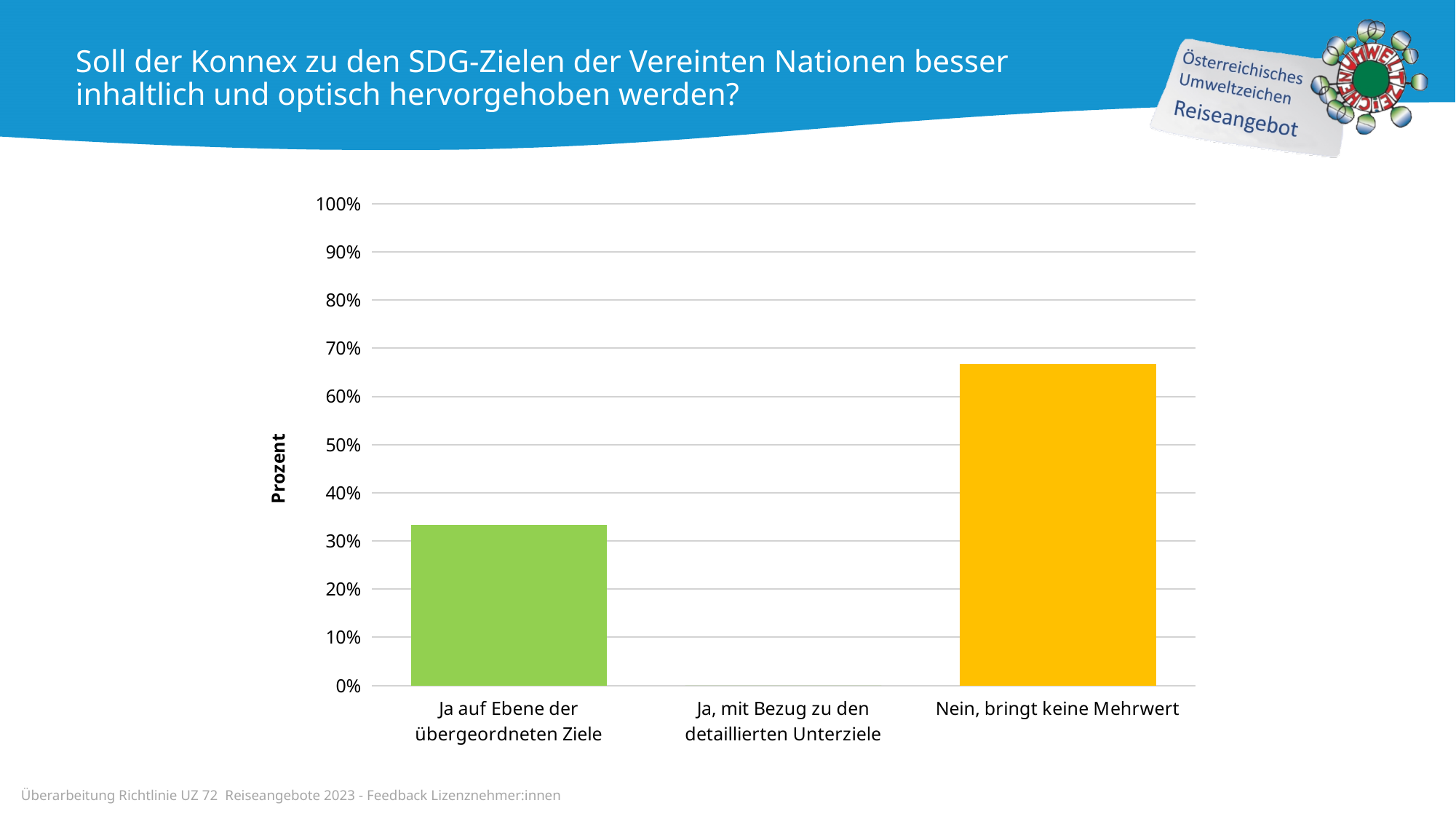
Is the value for "Ja auf Ebene der übergeordneten Ziele" greater or less than 40%? less What is the value for "Ja, mit Bezug zu den detaillierten Unterziele"? 0% What is the label of the vertical axis of the chart? Prozent What colour is the bar for "Nein, bringt keine Mehrwert"? yellow How many categories are shown on the x axis of the chart? 3 Which is larger: the value for "Ja auf Ebene der übergeordneten Ziele" or the value for "Nein, bringt keine Mehrwert"? Nein, bringt keine Mehrwert Is the value for "Ja auf Ebene der übergeordneten Ziele" greater or less than 30%? greater Which category has the lowest value in the chart? Ja, mit Bezug zu den detaillierten Unterziele What kind of chart is shown on the slide? bar chart Is the value for "Nein, bringt keine Mehrwert" greater or less than 60%? greater Which category has the highest value in the chart? Nein, bringt keine Mehrwert